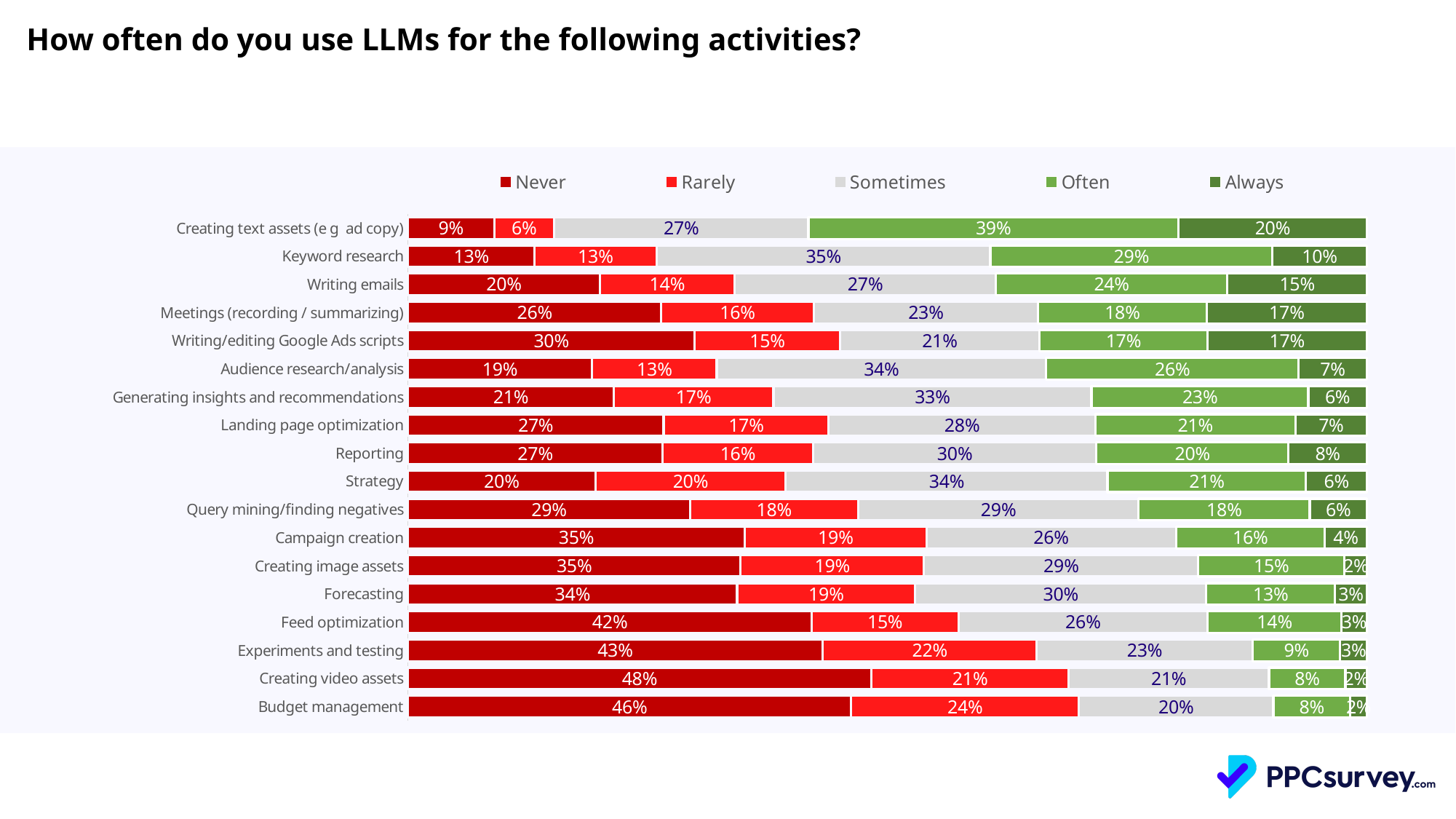
What type of chart is shown on the slide? Stacked bar chart What is the 'Never' value for Creating video assets? 48% What is the total of the stacked bar for Keyword research? 100% Which activity has the highest 'Never' value? Creating video assets What is the 'Always' value for Writing emails? 15% What is the 'Sometimes' value for Keyword research? 35% What is the difference between the 'Often' value for Creating text assets and the 'Often' value for Keyword research? 10 percentage points How many activities are listed in the chart? 18 Which activity has the highest 'Often' value? Creating text assets (e g ad copy) How many series does the legend list? 5 Which activity has the lowest 'Never' value? Creating text assets (e g ad copy) Which is larger: the 'Never' value for Feed optimization or the 'Never' value for Experiments and testing? Experiments and testing